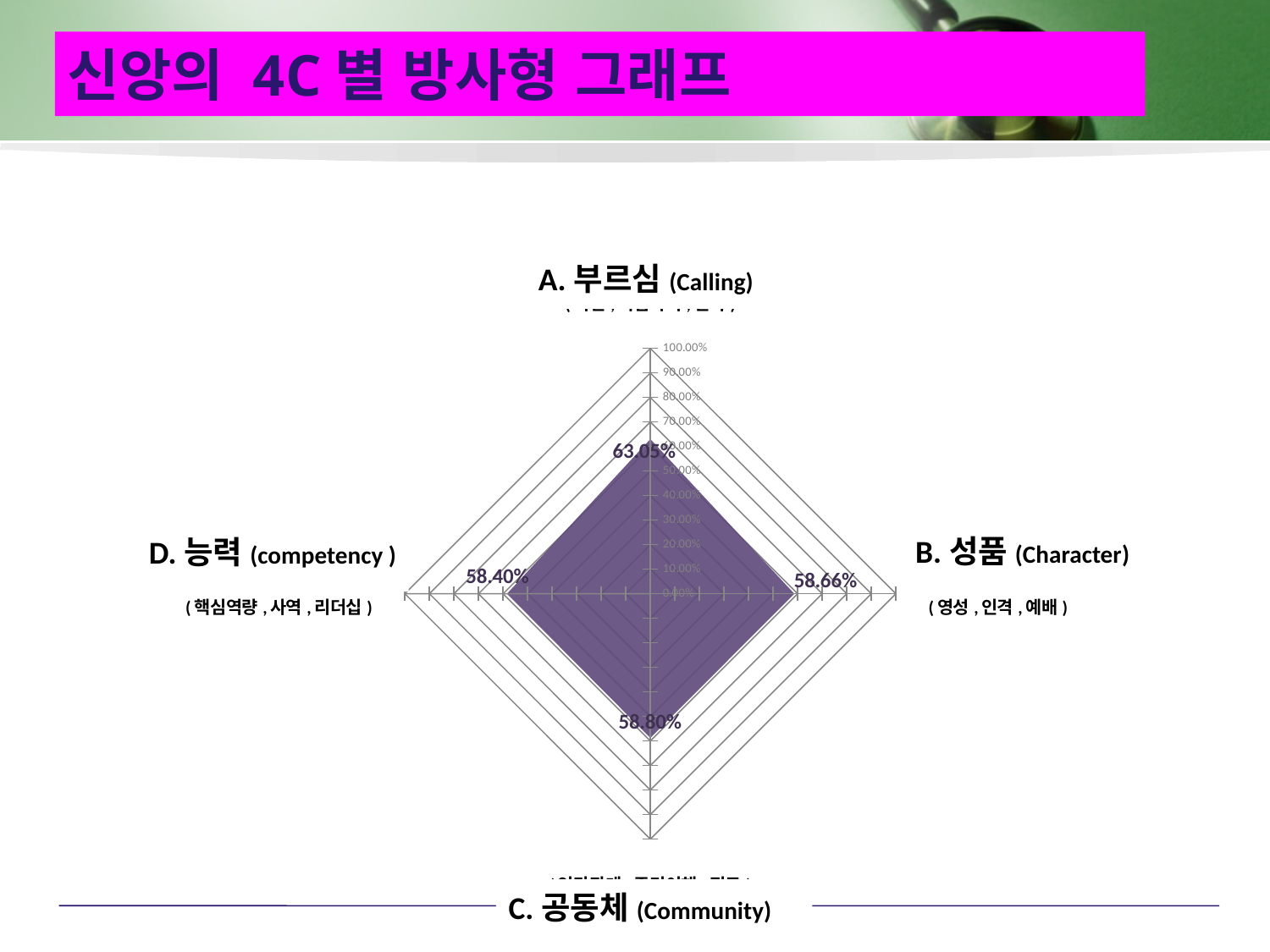
What is the value for B. 성품 (Character)? 58.66% Is the value for A. 부르심 (Calling) greater or less than 60.00%? greater What is the value for C. 공동체 (Community)? 58.80% What is the value for A. 부르심 (Calling)? 63.05% What is the title of the slide containing the chart? 신앙의 4C 별 방사형 그래프 Which is larger, the value for C. 공동체 (Community) or D. 능력 (competency)? C. 공동체 (Community) How many categories (axes) does the radar chart have? 4 What is the value for D. 능력 (competency)? 58.40% Which category has the highest value? A. 부르심 (Calling) What kind of chart is shown on the slide? Radar chart Which category has the lowest value? D. 능력 (competency) What is the difference between the values for A. 부르심 (Calling) and B. 성품 (Character)? 4.39%